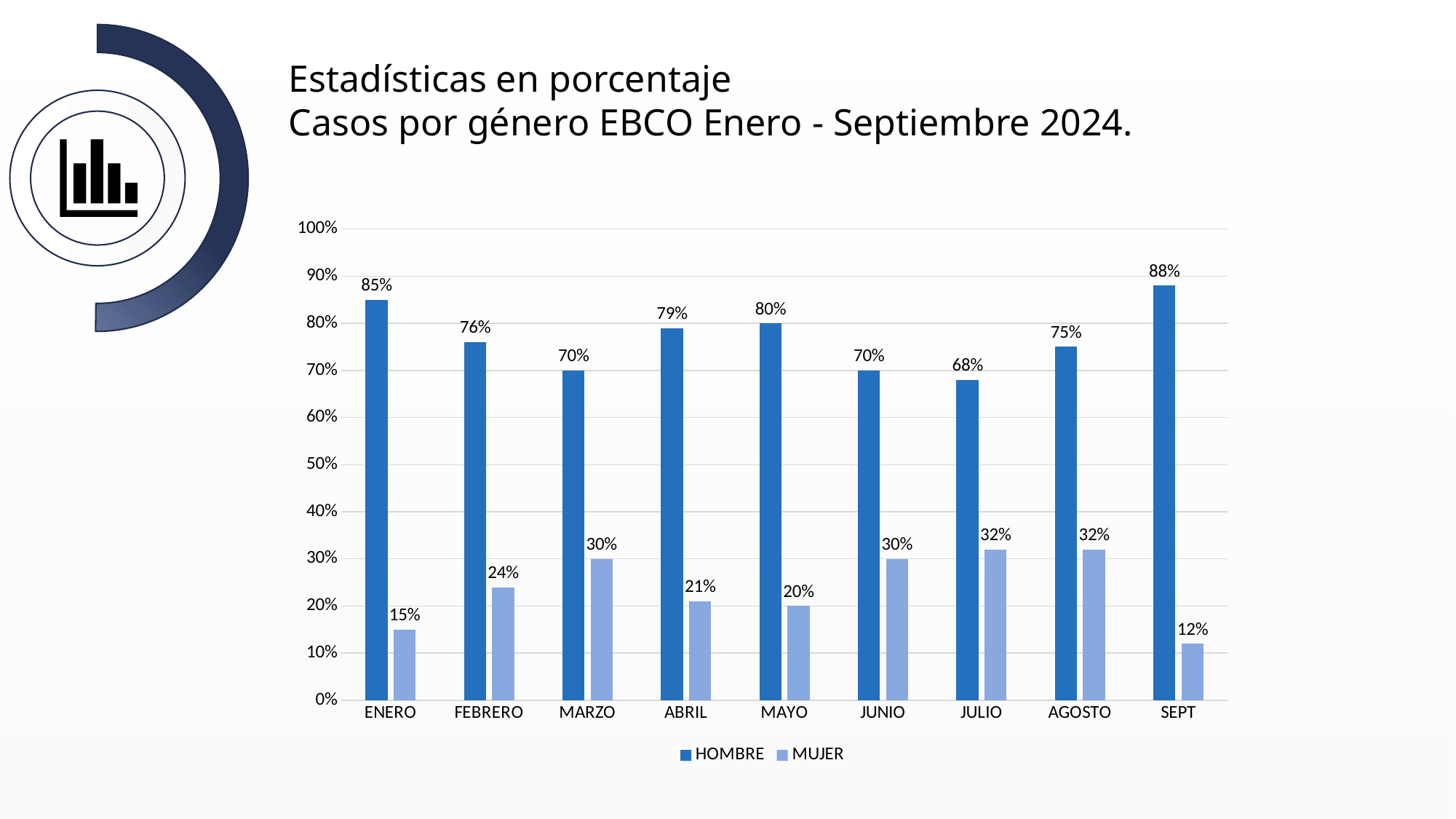
Which month has the highest HOMBRE value? SEPT Which month has the lowest HOMBRE value? JULIO What is the MUJER value for AGOSTO? 32% What is the difference between the HOMBRE and MUJER values for MAYO? 60% What is the HOMBRE value for ENERO? 85% How many series does the legend list? 2 What kind of chart is shown on the slide? bar chart Is the HOMBRE value for ABRIL greater or less than 70%? greater How many months are shown on the x axis? 9 What are the two series named in the legend? HOMBRE and MUJER Which is larger, the MUJER value for FEBRERO or the MUJER value for MARZO? MARZO Which month has the lowest MUJER value? SEPT